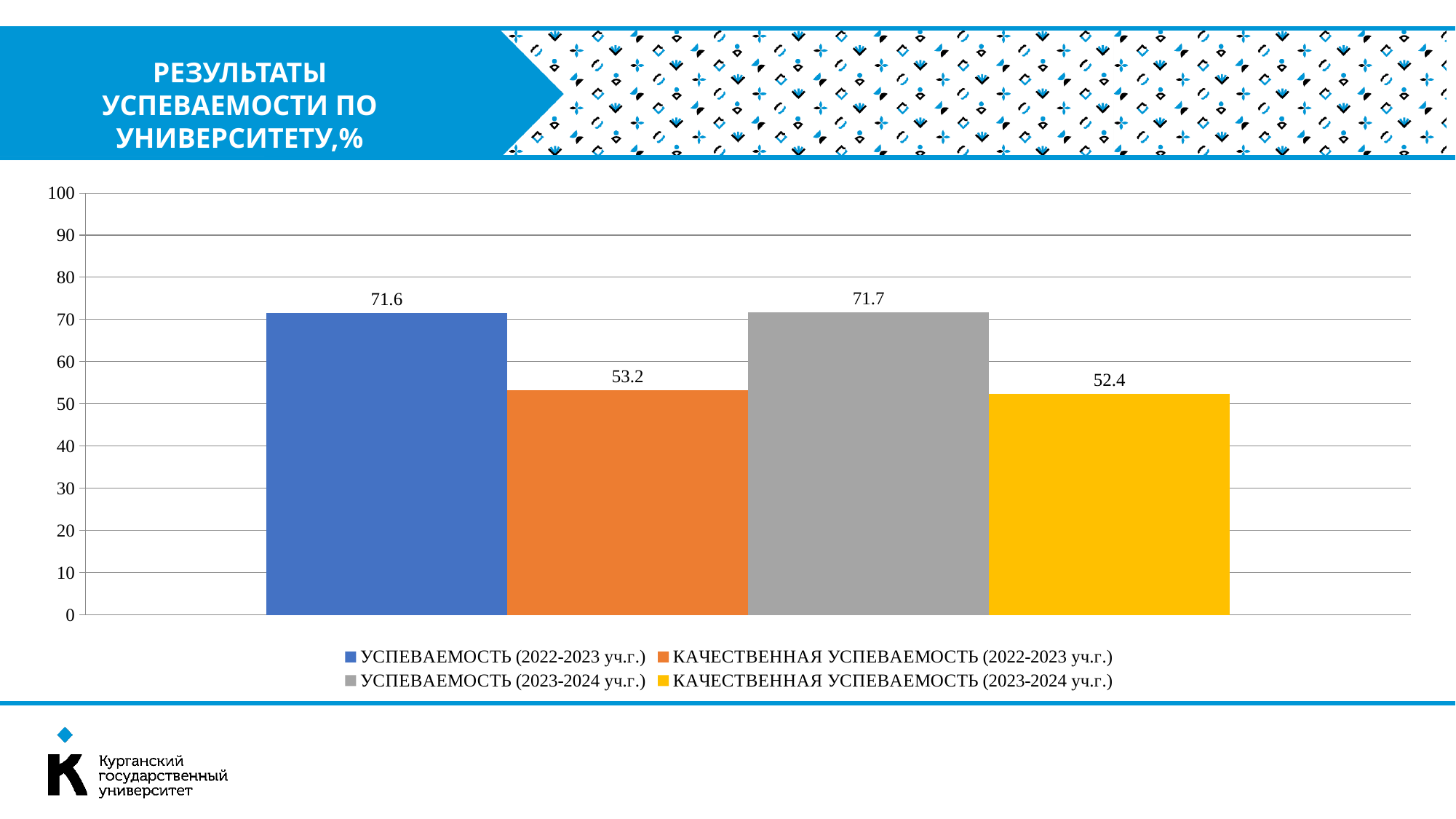
What is the value for КАЧЕСТВЕННАЯ УСПЕВАЕМОСТЬ (2022-2023 уч.г.)? 53.2 Which is larger: УСПЕВАЕМОСТЬ (2023-2024 уч.г.) or КАЧЕСТВЕННАЯ УСПЕВАЕМОСТЬ (2022-2023 уч.г.)? УСПЕВАЕМОСТЬ (2023-2024 уч.г.) Is the value for КАЧЕСТВЕННАЯ УСПЕВАЕМОСТЬ (2023-2024 уч.г.) greater or less than 60? less What is the value for УСПЕВАЕМОСТЬ (2023-2024 уч.г.)? 71.7 What is the value for УСПЕВАЕМОСТЬ (2022-2023 уч.г.)? 71.6 How many series does the legend list? 4 What colour is the bar for УСПЕВАЕМОСТЬ (2023-2024 уч.г.)? grey What kind of chart is shown on the slide? bar chart What is the difference between УСПЕВАЕМОСТЬ (2023-2024 уч.г.) and КАЧЕСТВЕННАЯ УСПЕВАЕМОСТЬ (2023-2024 уч.г.)? 19.3 Is the value for УСПЕВАЕМОСТЬ (2022-2023 уч.г.) greater or less than 70? greater What is the value for КАЧЕСТВЕННАЯ УСПЕВАЕМОСТЬ (2023-2024 уч.г.)? 52.4 What is the difference between УСПЕВАЕМОСТЬ (2022-2023 уч.г.) and КАЧЕСТВЕННАЯ УСПЕВАЕМОСТЬ (2022-2023 уч.г.)? 18.4